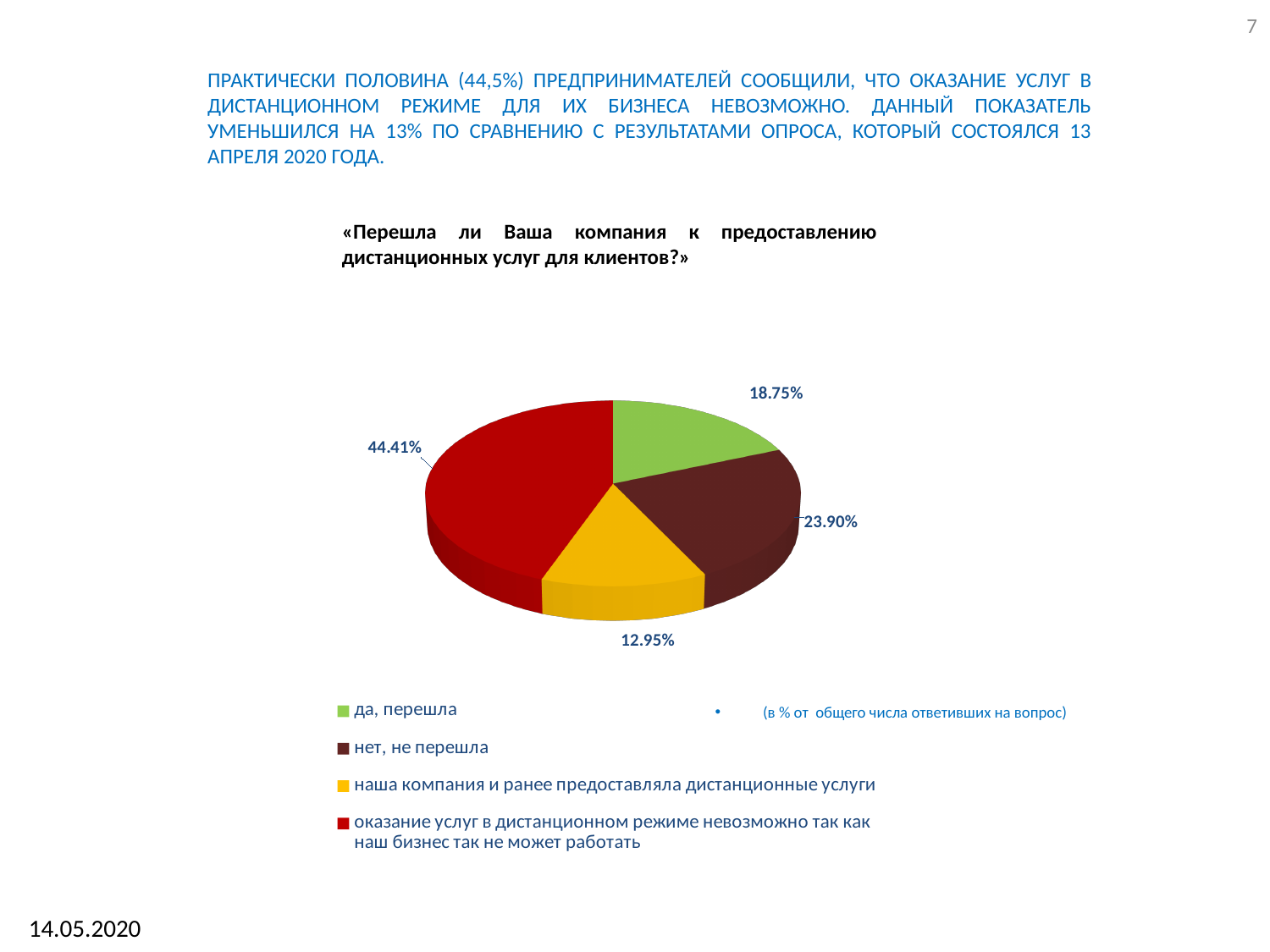
What percentage of respondents answered «наша компания и ранее предоставляла дистанционные услуги»? 12.95% What colour is the slice for «да, перешла»? green Which is larger: the share for «да, перешла» or the share for «нет, не перешла»? нет, не перешла What percentage of respondents answered «нет, не перешла»? 23.90% What percentage of respondents answered «да, перешла»? 18.75% What percentage of respondents answered «оказание услуг в дистанционном режиме невозможно так как наш бизнес так не может работать»? 44.41% How many slices does the pie chart have? 4 What is the difference in percentage points between «нет, не перешла» and «да, перешла»? 5.15 How many entries does the legend list? 4 Which answer option has the largest share of the pie? оказание услуг в дистанционном режиме невозможно так как наш бизнес так не может работать What type of chart is shown on the slide? pie chart Which answer option has the smallest share of the pie? наша компания и ранее предоставляла дистанционные услуги